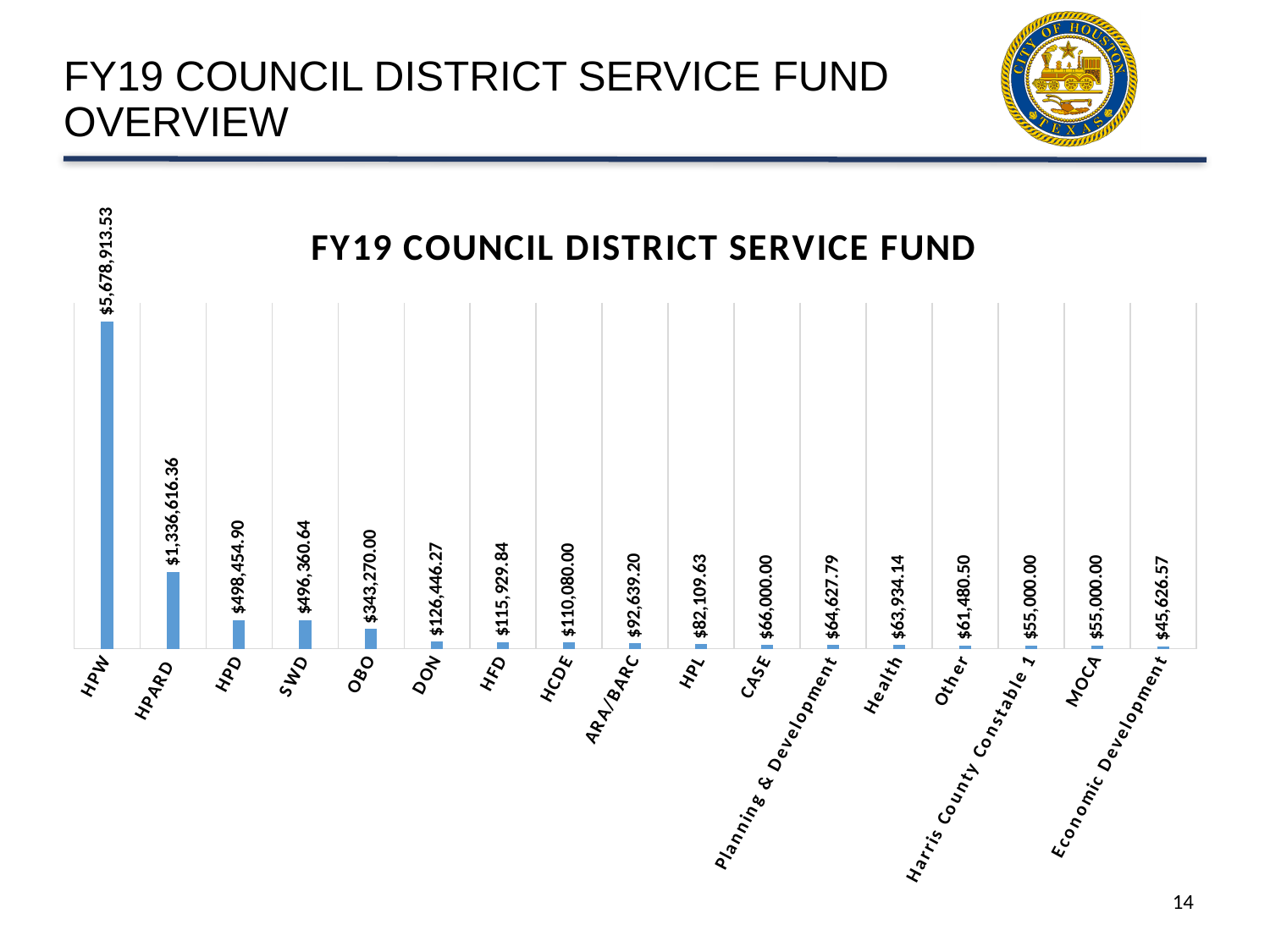
What is the value for Economic Development? $45,626.57 What is the difference between the values for HPW and HPARD? $4,342,297.17 What is the difference between the values for HCDE and HPL? $27,970.37 Which category has the lowest value? Economic Development What is the value for Planning & Development? $64,627.79 What is the value for HPARD? $1,336,616.36 What is the value for OBO? $343,270.00 How many categories are shown in the chart? 17 What is the value for HPW in the FY19 Council District Service Fund chart? $5,678,913.53 What type of chart is shown on the slide? Bar chart Which category has the highest value? HPW Which is larger, the value for DON or the value for HFD? DON